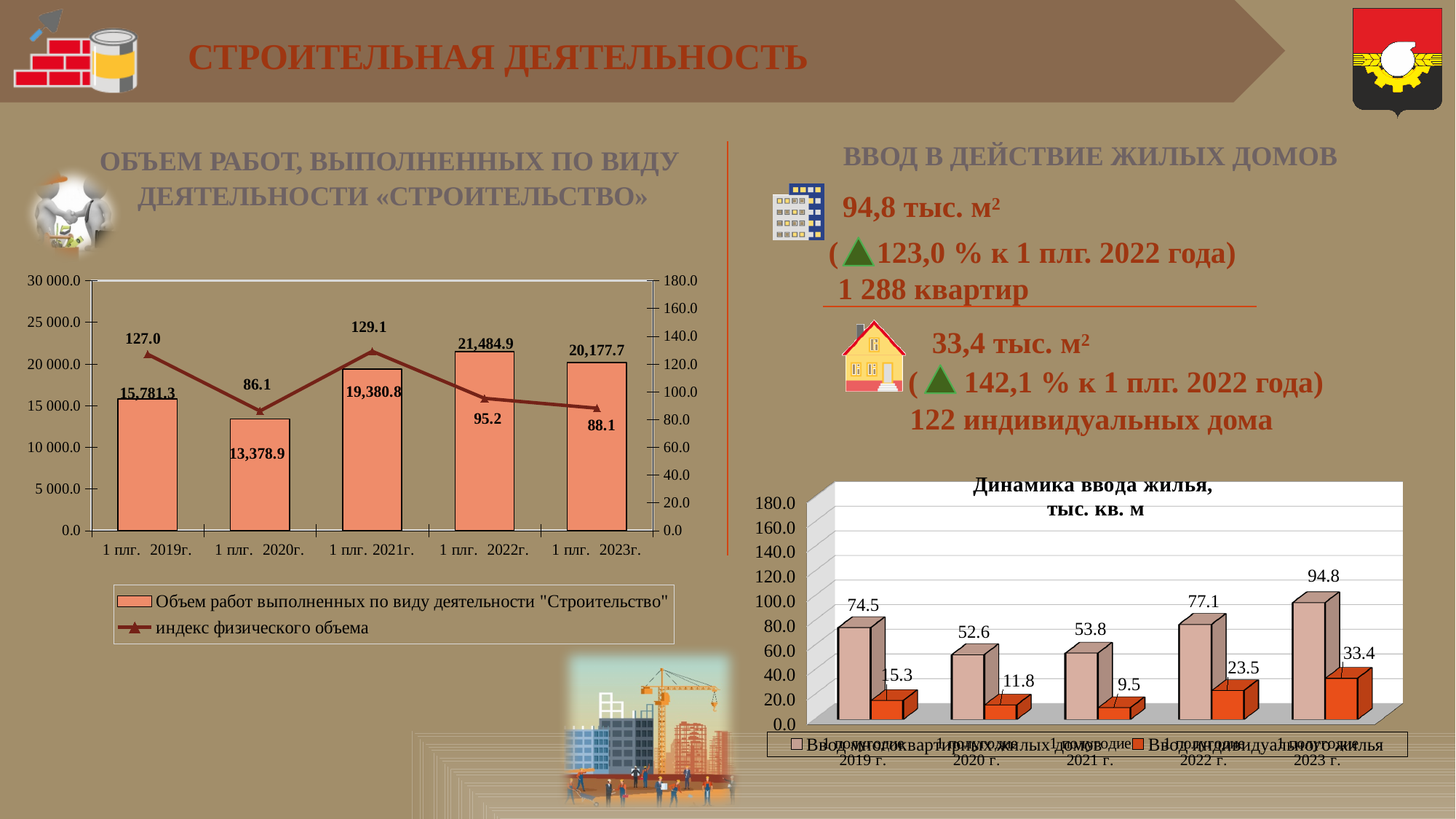
What kind of chart is the chart titled 'Динамика ввода жилья, тыс. кв. м'? bar chart In the chart titled 'Динамика ввода жилья, тыс. кв. м', which period has the highest value for Ввод многоквартирных жилых домов? 1 полугодие 2023 г. In the chart titled 'Динамика ввода жилья, тыс. кв. м', which period has the lowest value for Ввод индивидуального жилья? 1 полугодие 2021 г. In the left chart, is the bar value for 1 плг. 2019г. greater or less than 15 000.0? greater In the left chart, how many series does the legend list? 2 In the left chart, what is the value of the индекс физического объема line for 1 плг. 2021г.? 129.1 In the chart titled 'Динамика ввода жилья, тыс. кв. м', what is the difference between the Ввод многоквартирных жилых домов values for 1 полугодие 2023 г. and 1 полугодие 2019 г.? 20.3 In the chart titled 'Динамика ввода жилья, тыс. кв. м', how many periods are shown on the x axis? 5 In the left chart, which period has the lowest bar value? 1 плг. 2020г. In the left chart, what is the difference between the bar values for 1 плг. 2022г. and 1 плг. 2023г.? 1,307.2 In the chart titled 'Динамика ввода жилья, тыс. кв. м', what is the value for Ввод индивидуального жилья in 1 полугодие 2022 г.? 23.5 In the left chart, what is the value of the bar for 1 плг. 2022г.? 21,484.9